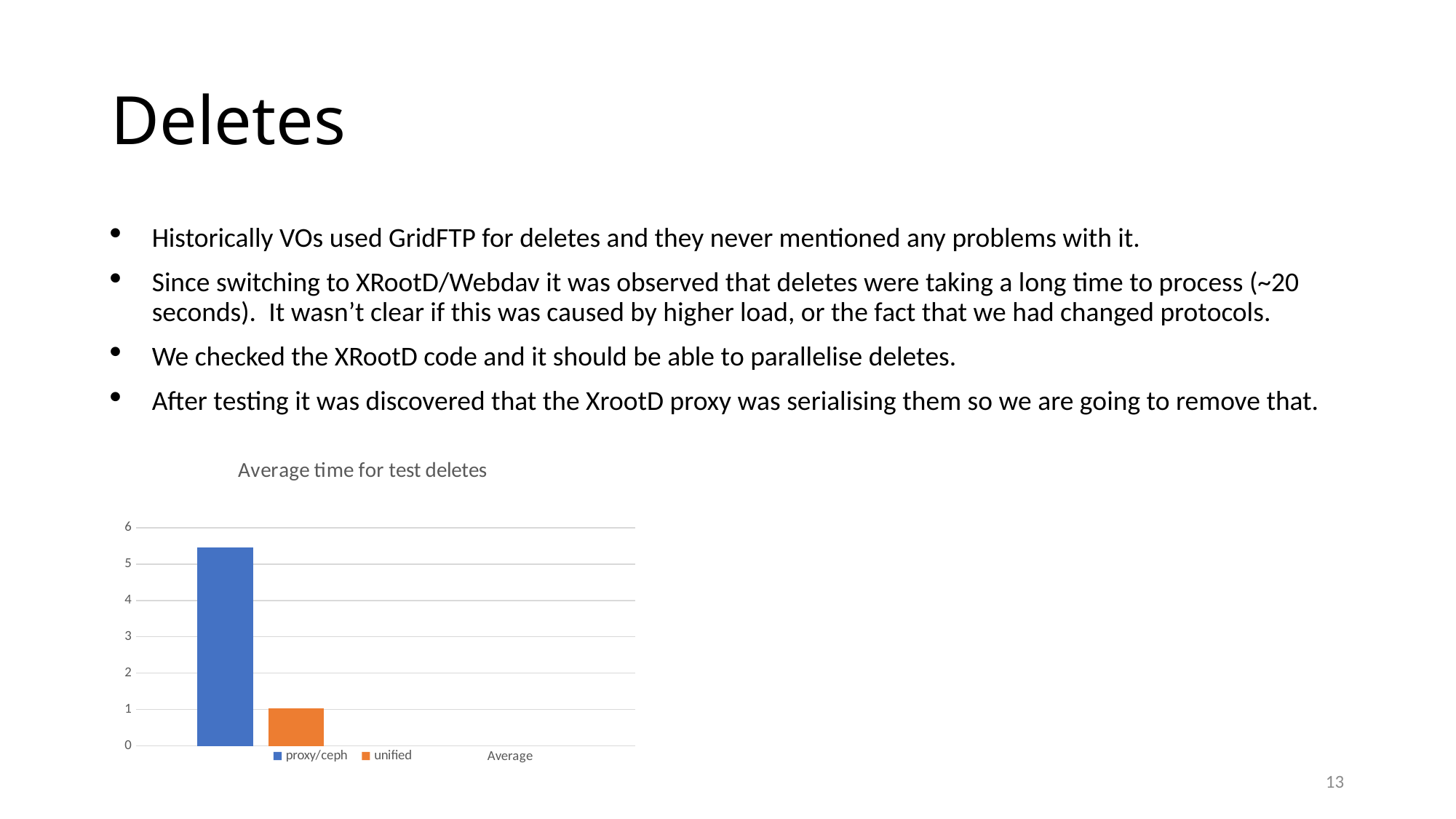
What kind of chart is shown on the slide? bar chart How many series does the chart legend list? 2 Which is larger, the bar for proxy/ceph or the bar for unified? proxy/ceph Is the value for unified greater or less than 2? less Which series has the lowest bar in the chart? unified What is the label of the category on the x axis of the chart? Average Is the value for proxy/ceph greater or less than 4? greater Is the value for proxy/ceph greater or less than 6? less What are the two series named in the chart legend? proxy/ceph and unified What is the title of the chart? Average time for test deletes Which series has the highest bar in the chart? proxy/ceph